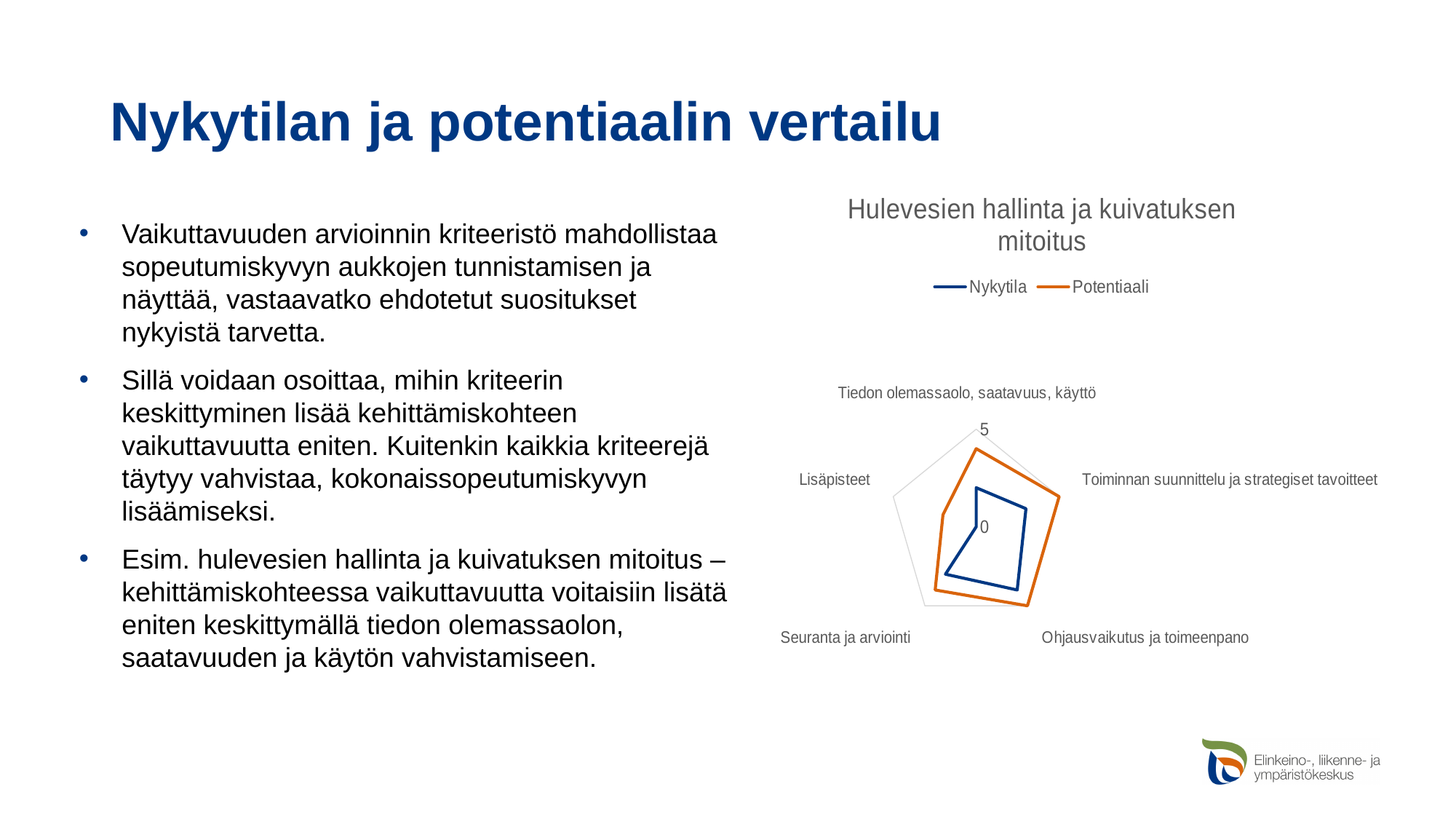
For which category is the Potentiaali value lowest? Lisäpisteet How many categories (axes) does the radar chart have? 5 For which category is the Nykytila value lowest? Lisäpisteet Is the Nykytila value for Lisäpisteet greater or less than 5? less What kind of chart is shown on the slide? Radar chart Which series is drawn in orange? Potentiaali How many series does the chart legend list? 2 Is the Nykytila value for Tiedon olemassaolo, saatavuus, käyttö greater or less than 5? less For Seuranta ja arviointi, which series has the larger value, Nykytila or Potentiaali? Potentiaali What is the title of the chart? Hulevesien hallinta ja kuivatuksen mitoitus For Lisäpisteet, which series has the larger value, Nykytila or Potentiaali? Potentiaali For Tiedon olemassaolo, saatavuus, käyttö, which series has the larger value, Nykytila or Potentiaali? Potentiaali